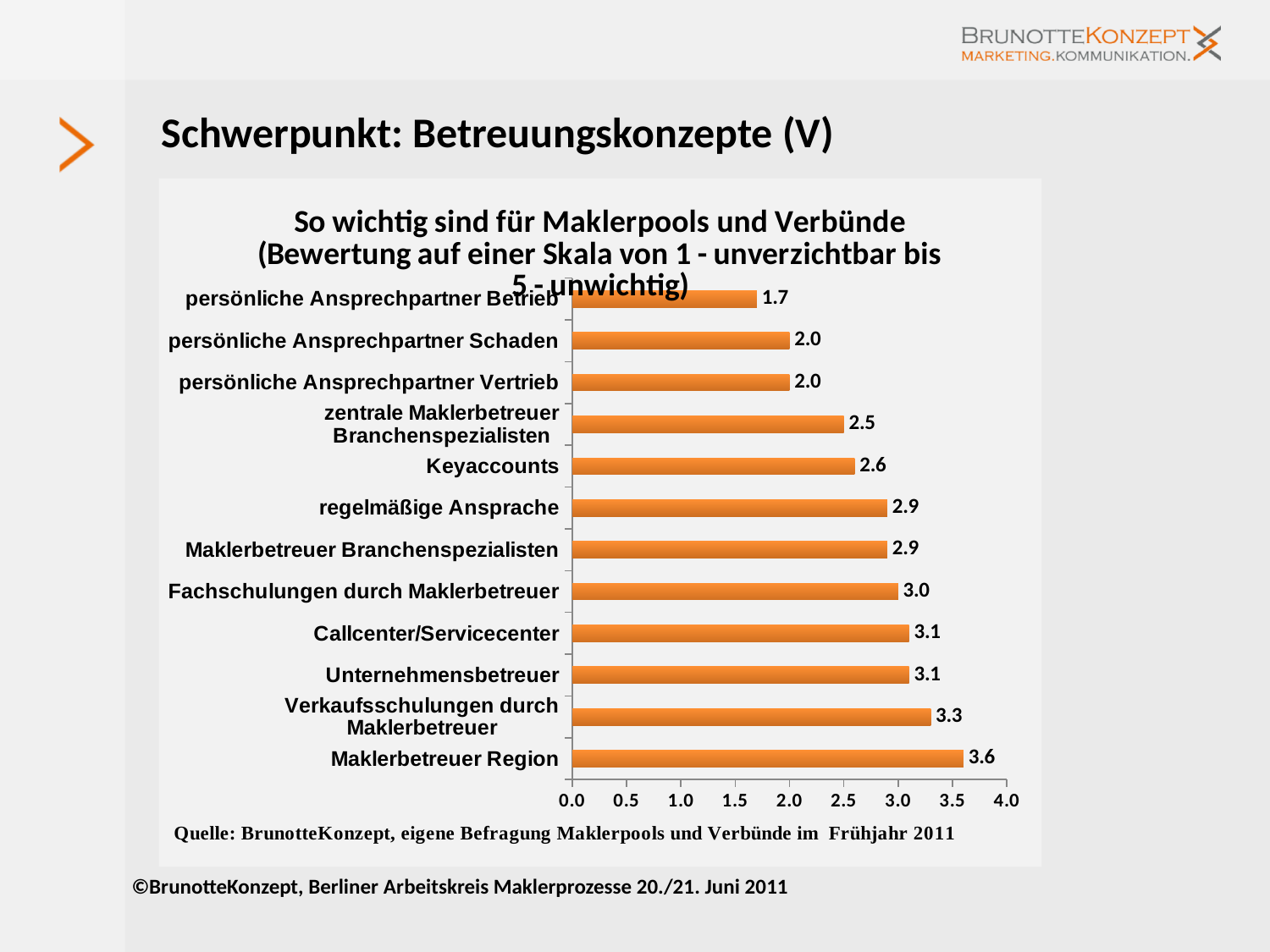
Is the value for zentrale Maklerbetreuer Branchenspezialisten greater or less than 3.0? less What is the value for Maklerbetreuer Region? 3.6 What is the maximum value shown on the x axis? 4.0 How many categories are shown in the chart? 12 What is the value for Callcenter/Servicecenter? 3.1 Which is larger, the value for Verkaufsschulungen durch Maklerbetreuer or the value for Fachschulungen durch Maklerbetreuer? Verkaufsschulungen durch Maklerbetreuer What colour are the bars in the chart? orange What is the value for Keyaccounts? 2.6 Which category has the lowest value? persönliche Ansprechpartner Betrieb What kind of chart is shown on the slide? bar chart What is the difference between the values for Maklerbetreuer Region and persönliche Ansprechpartner Betrieb? 1.9 Which category has the highest value? Maklerbetreuer Region